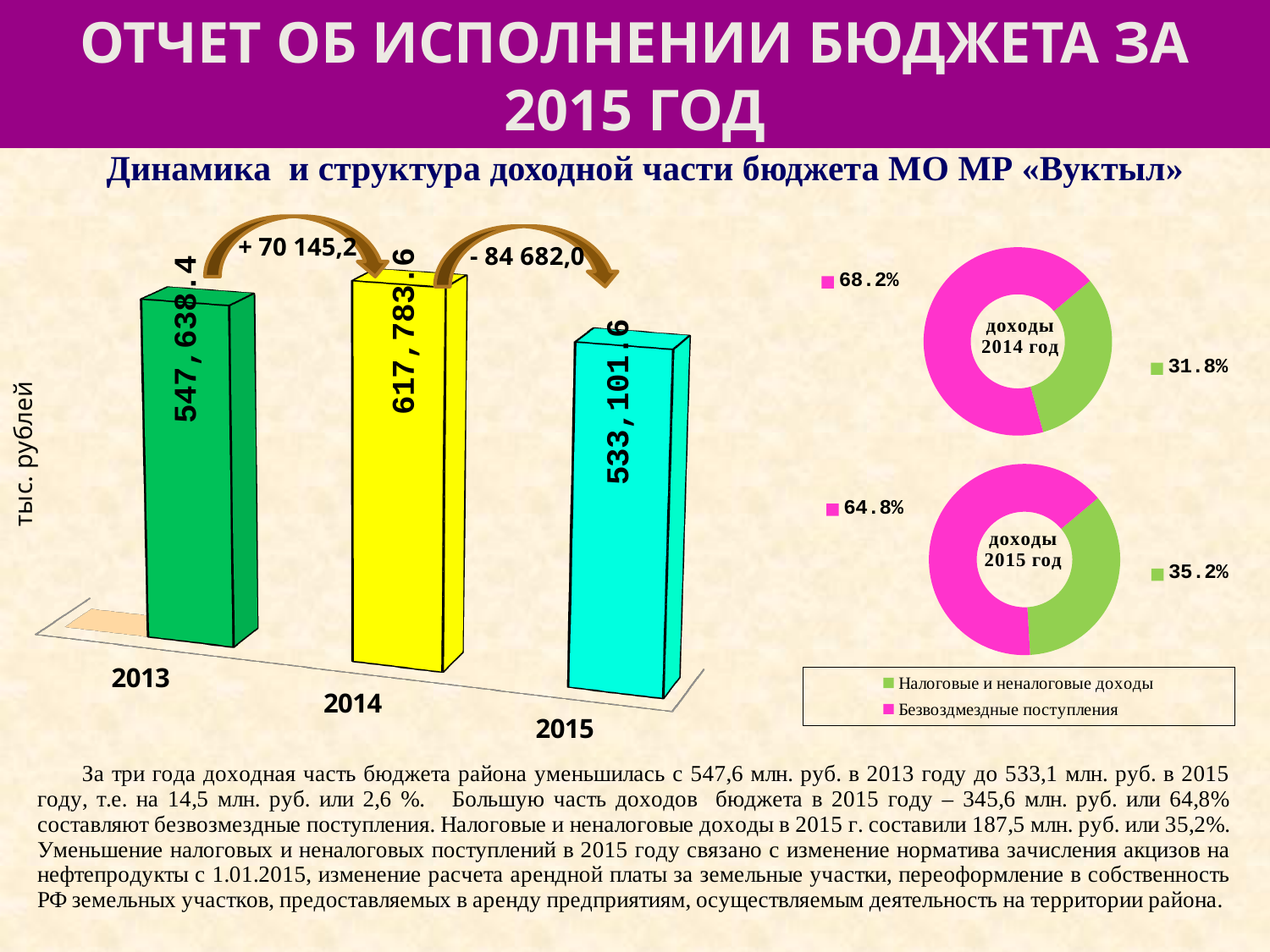
In the donut chart 'доходы 2014 год', what share is Налоговые и неналоговые доходы? 31.8% In the bar chart, what is the difference between the values for 2014 and 2013? 70,145.2 In the bar chart, which year has the lowest value? 2015 In the bar chart, what is the value for 2014? 617,783.6 What kind of chart is the chart on the left of the slide? bar chart In the bar chart, which year has the highest value? 2014 In the bar chart, what is the value for 2013? 547,638.4 In the bar chart, what is the value for 2015? 533,101.6 In the bar chart, which is larger, the value for 2013 or the value for 2015? 2013 In the donut chart 'доходы 2015 год', what share is Безвозмездные поступления? 64.8% In the bar chart, what is the difference between the values for 2014 and 2015? 84,682.0 How many years are shown in the bar chart? 3